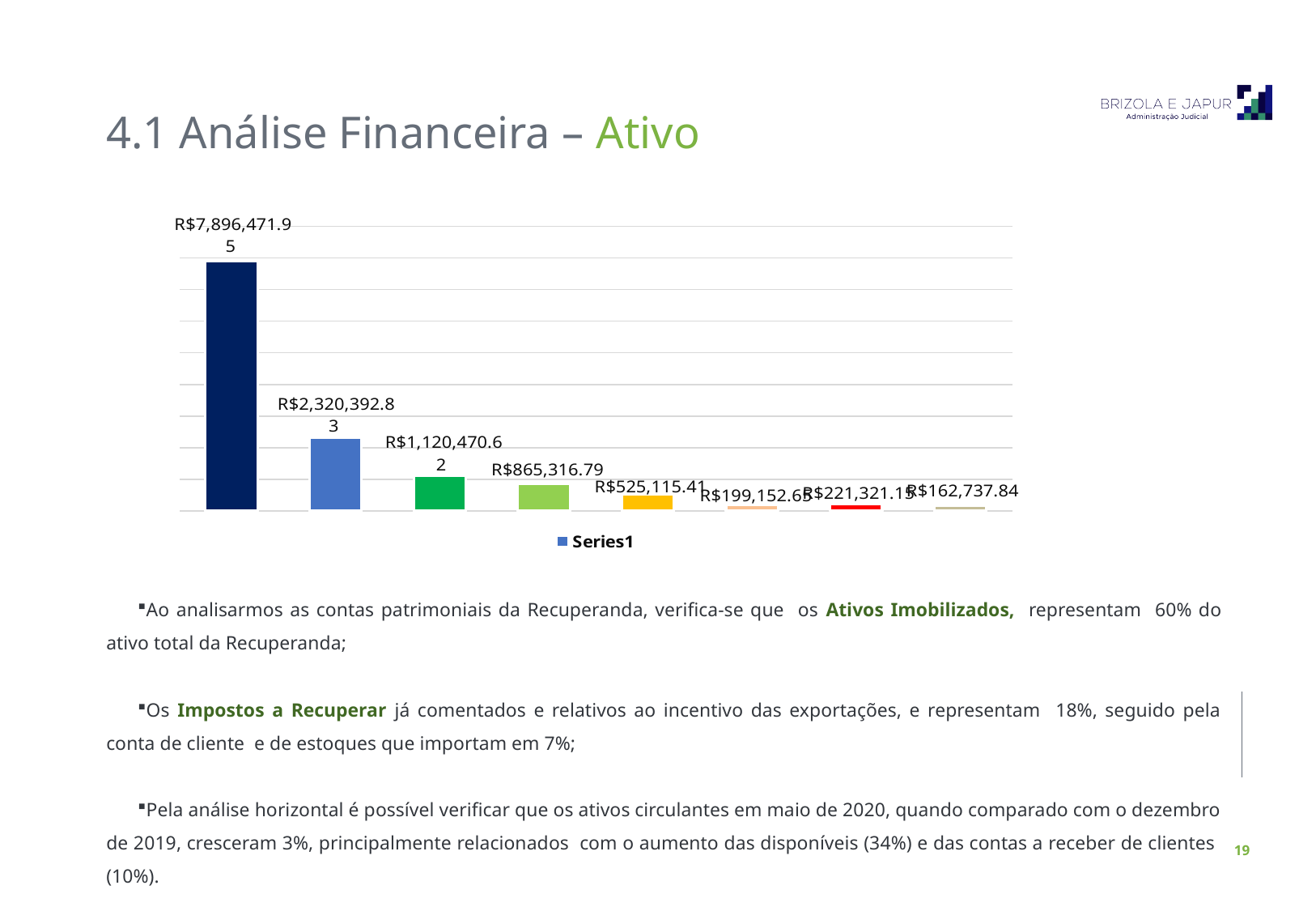
Which bar has the highest value in the chart? the first (leftmost, dark blue) bar How many series does the chart legend list? 1 Which is larger, the value of the second bar or the value of the third bar? the second bar How many bars are plotted in the chart? 8 What is the value shown on the fifth (yellow) bar? R$525,115.41 What is the value shown on the fourth (light green) bar? R$865,316.79 What is the value shown on the last (rightmost) bar? R$162,737.84 What is the value shown on the second (medium blue) bar? R$2,320,392.83 What is the value shown on the first (leftmost, dark blue) bar? R$7,896,471.95 What type of chart is shown on the slide? bar chart What is the value shown on the third (green) bar? R$1,120,470.62 What is the name of the series shown in the chart legend? Series1